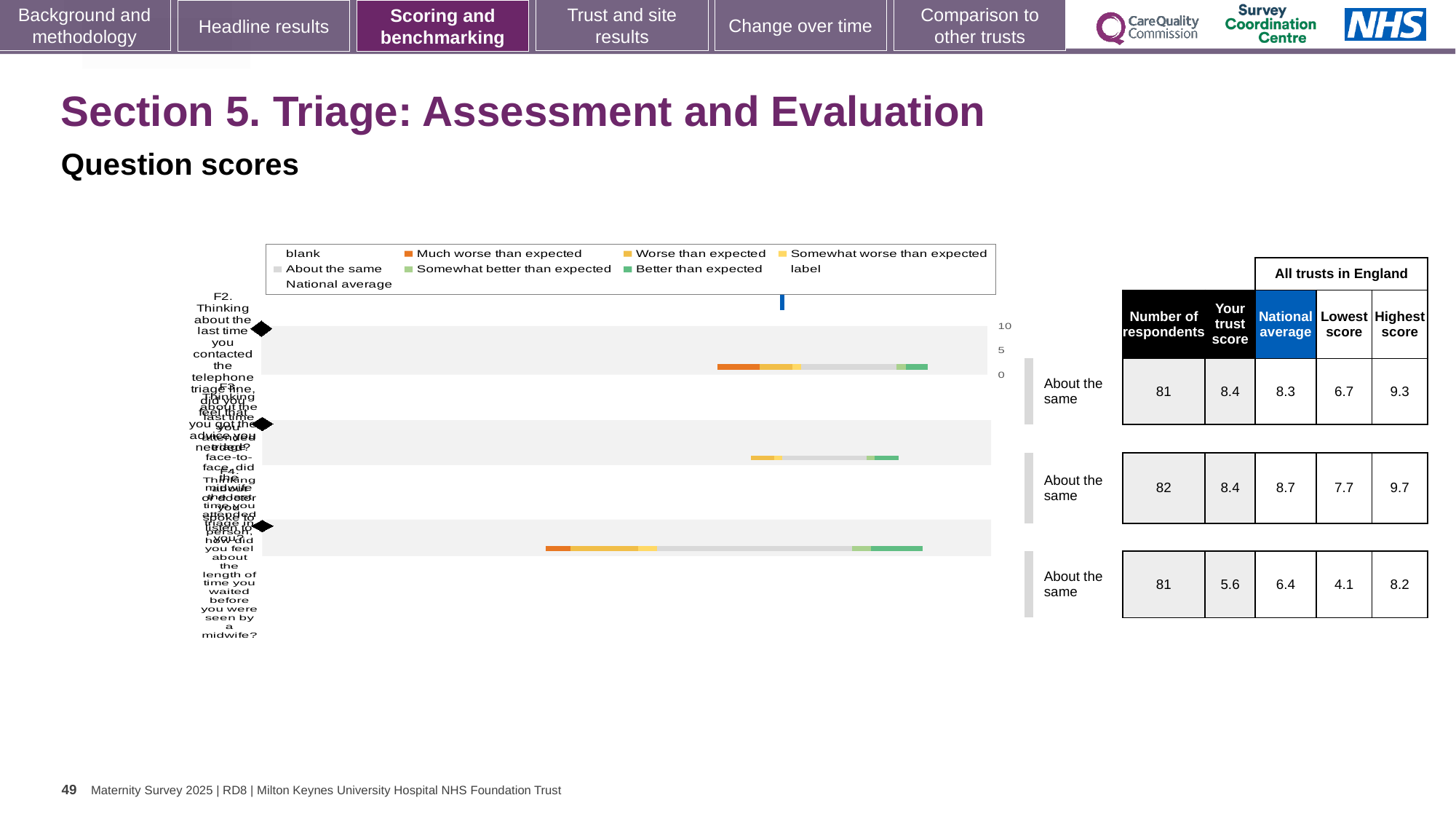
What benchmark category is given for all three rows? About the same What is the number of respondents for the second row? 82 What is the highest value shown on the chart's numeric axis? 10 Is the trust score for the second row larger or smaller than its national average? smaller What is the difference between the national average and the trust score for the third row? 0.8 Which row has the lowest 'Your trust score'? the third row What kind of chart is shown on the slide? bar chart What is the national average for the first row (F2)? 8.3 What is the 'Your trust score' for the first row (F2, telephone triage line)? 8.4 Which row has the highest 'Highest score' among all trusts in England? the second row What is the 'Your trust score' for the third row? 5.6 How many question rows are plotted in the chart? 3